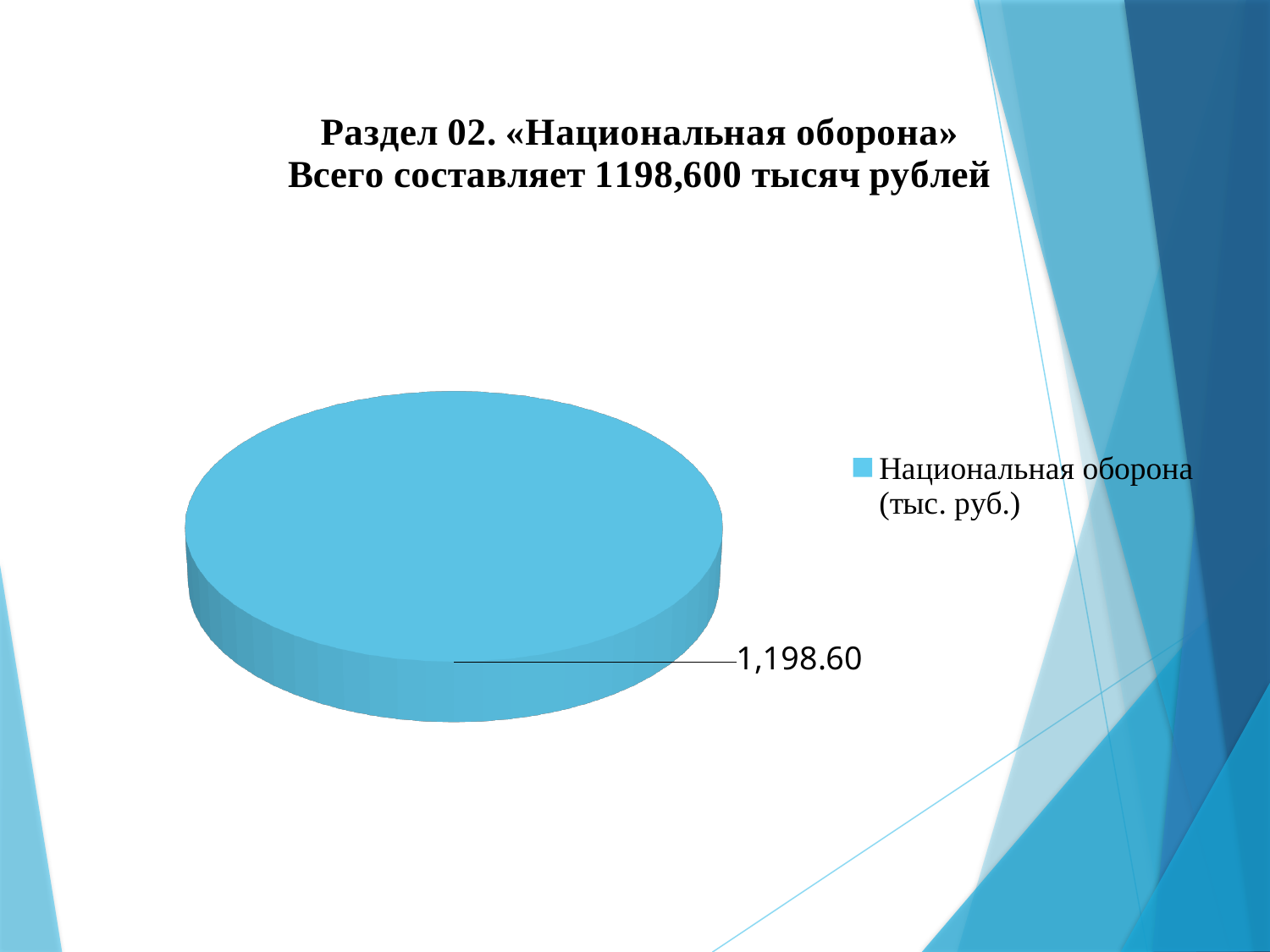
What share of the pie does the Национальная оборона (тыс. руб.) slice represent? 100% How many slices does the pie chart have? 1 What is the legend entry shown on the chart? Национальная оборона (тыс. руб.) Is the value for Национальная оборона (тыс. руб.) greater or less than 1,000? greater What is the value shown for Национальная оборона (тыс. руб.) on the pie chart? 1,198.60 What kind of chart is shown on the slide? pie chart How many entries does the legend list? 1 What colour is the pie slice? light blue